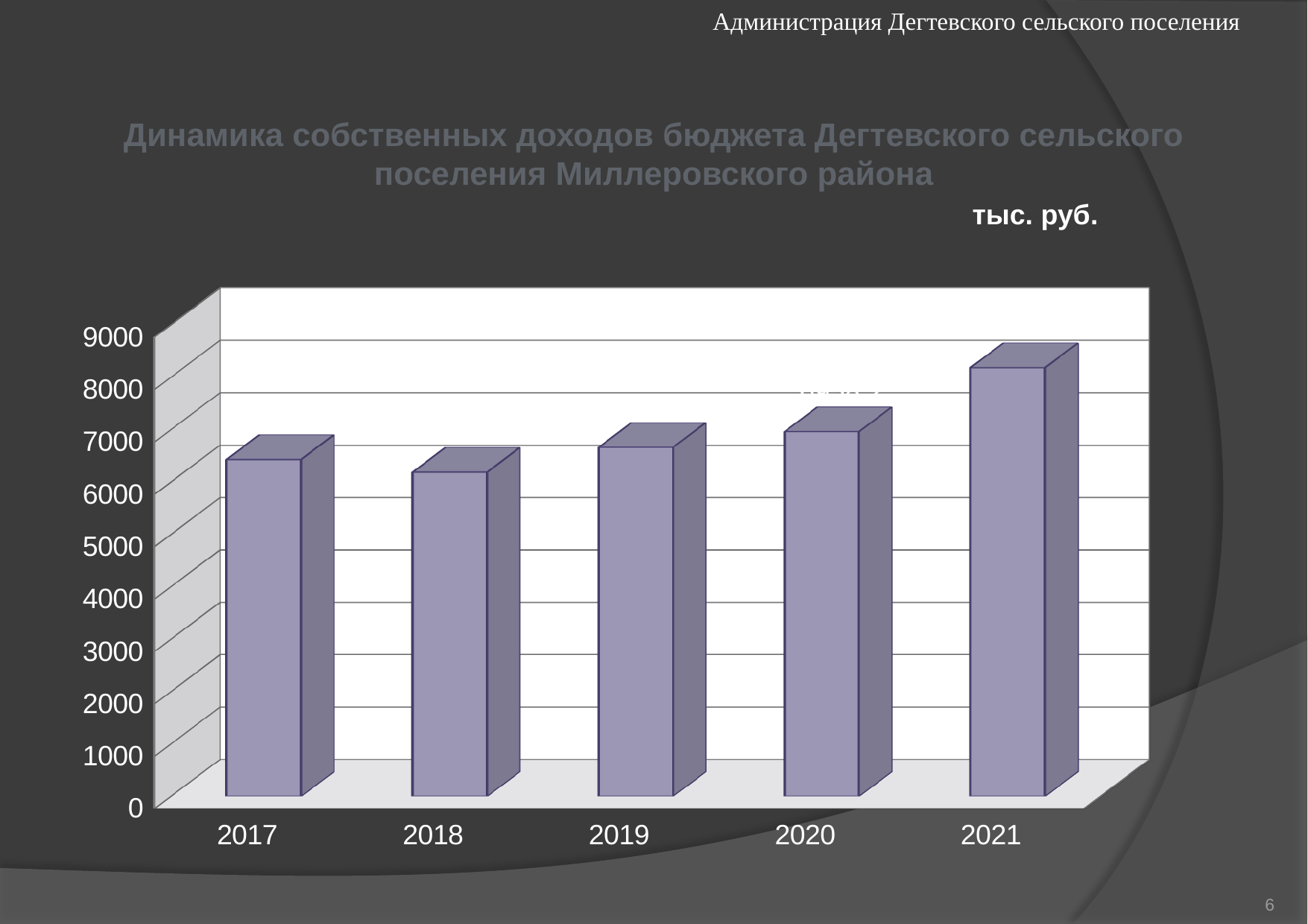
Which year has the highest value in the chart? 2021 Is the value for 2020 greater or less than 6000? greater What kind of chart is shown on the slide? bar chart Is the value for 2017 greater or less than 7000? less Which is larger, the value for 2021 or the value for 2020? 2021 How many years are shown on the x axis of the chart? 5 What unit of measurement is indicated above the chart? тыс. руб. Is the value for 2021 greater or less than 8000? greater Do the values generally rise or fall from 2017 to 2021? rise Which year has the lowest value in the chart? 2018